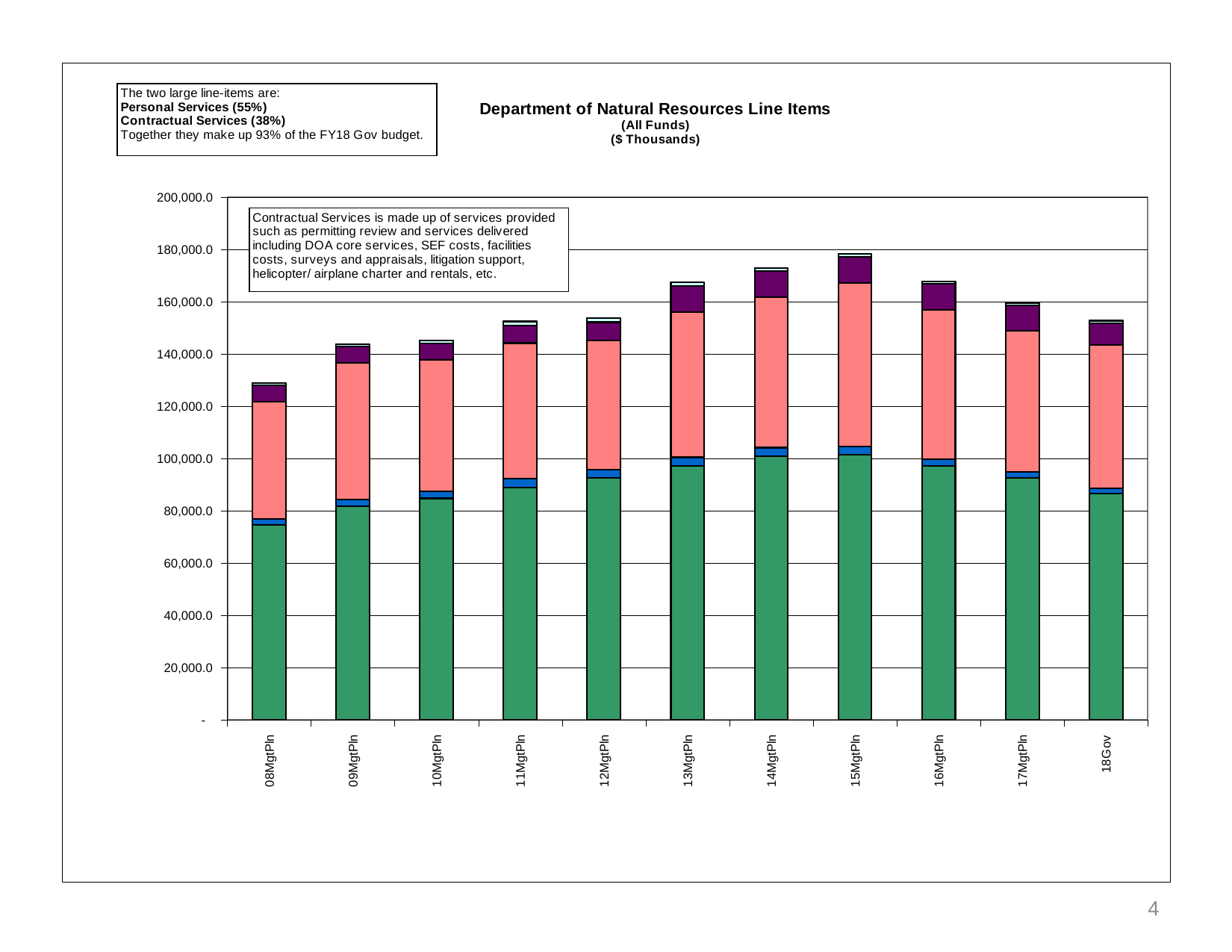
What kind of chart is shown on the slide? Stacked bar chart What is the title of the chart? Department of Natural Resources Line Items (All Funds) ($ Thousands) Is the total for 15MgtPln greater or less than 160,000.0? greater Is the total for 14MgtPln greater or less than 160,000.0? greater Which category has the tallest stacked bar? 15MgtPln Is the total for 08MgtPln greater or less than 140,000.0? less In what units are the chart values expressed, according to the title? $ Thousands Which category has the shortest stacked bar? 08MgtPln How many categories are shown along the x axis of the chart? 11 Do the bar totals rise or fall from 08MgtPln to 15MgtPln? rise Which has the larger total, 14MgtPln or 18Gov? 14MgtPln